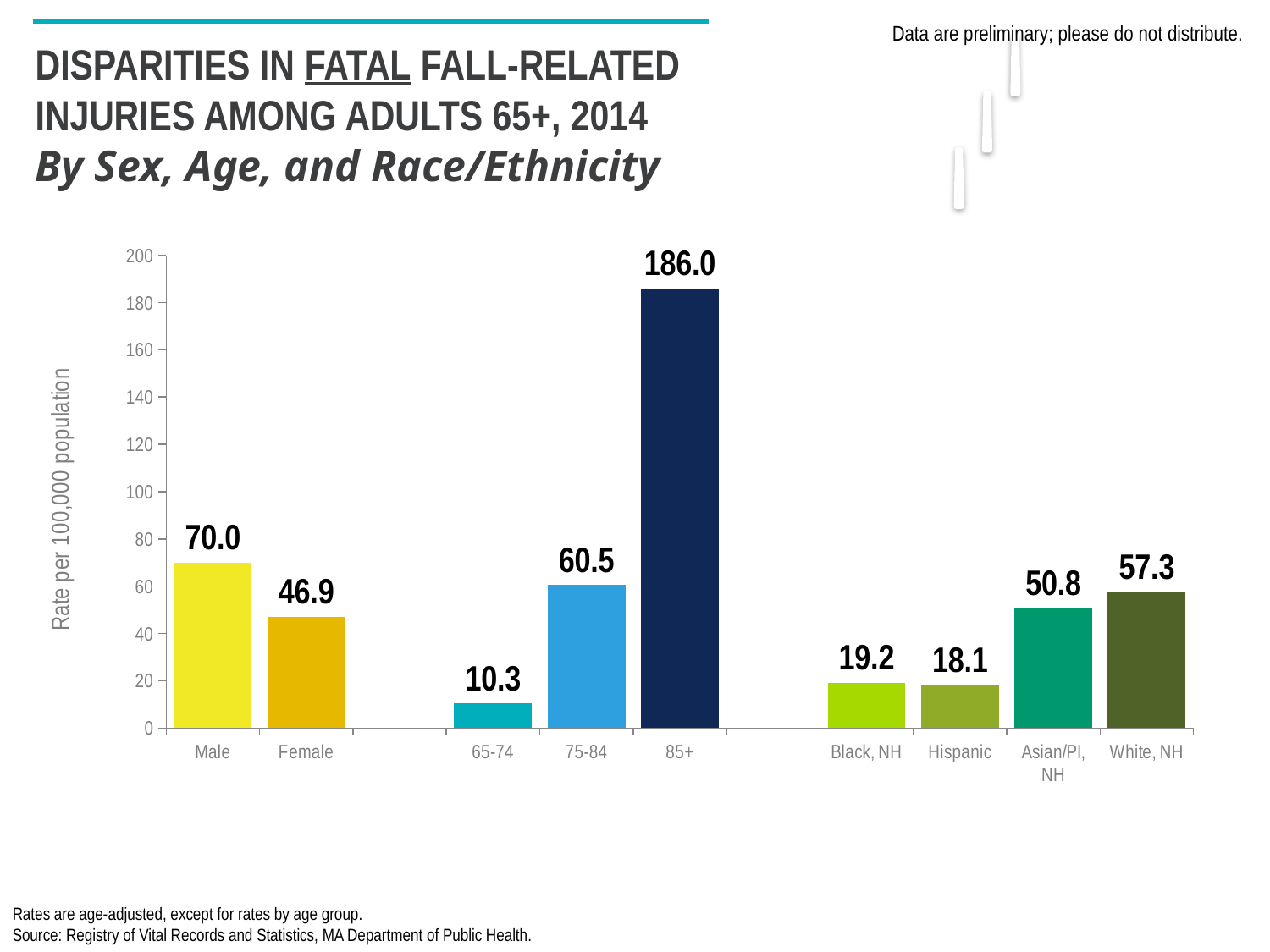
Which category has the lowest rate? 65-74 How many bars are plotted on the chart? 9 Which category has the highest rate? 85+ What kind of chart is shown? bar chart Is the value for 75-84 greater or less than 80? less What is the difference between the Male and Female rates? 23.1 Which has a higher rate, White, NH or Asian/PI, NH? White, NH What is the rate for Male? 70.0 What is the label of the vertical axis? Rate per 100,000 population What is the rate for Hispanic? 18.1 Do the values rise or fall across the age groups from 65-74 to 85+? rise What is the rate for the 65-74 age group? 10.3